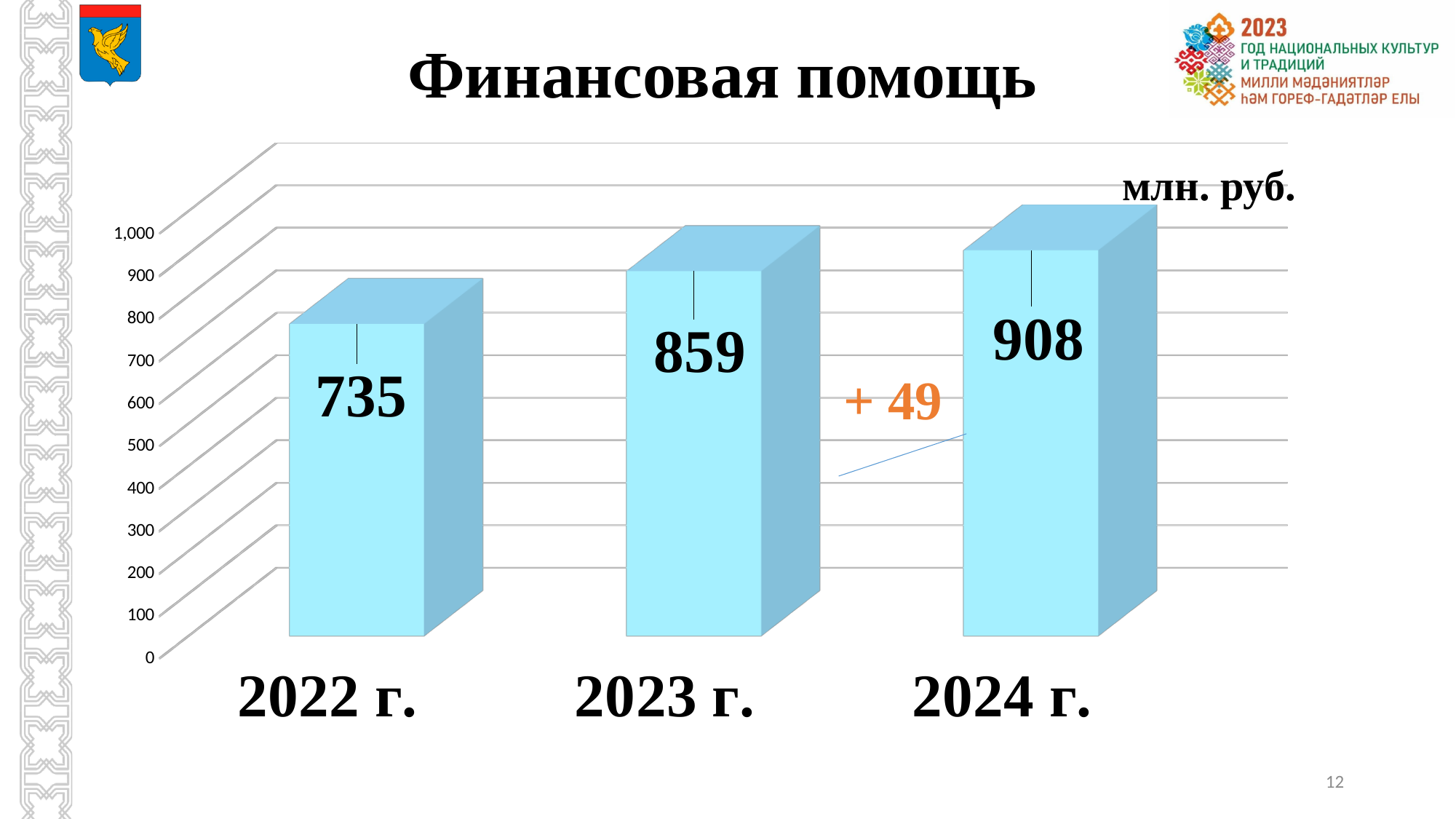
What kind of chart is shown on the slide? bar chart What is the value for 2022 г.? 735 What is the difference between the values for 2024 г. and 2023 г.? 49 What is the difference between the values for 2023 г. and 2022 г.? 124 Which is larger, the value for 2022 г. or the value for 2023 г.? 2023 г. Which year has the lowest value? 2022 г. Do the values rise or fall from 2022 г. to 2024 г.? rise What is the value for 2024 г.? 908 Is the value for 2022 г. greater or less than 800? less What is the value for 2023 г.? 859 Which year has the highest value? 2024 г. How many years are shown on the chart? 3